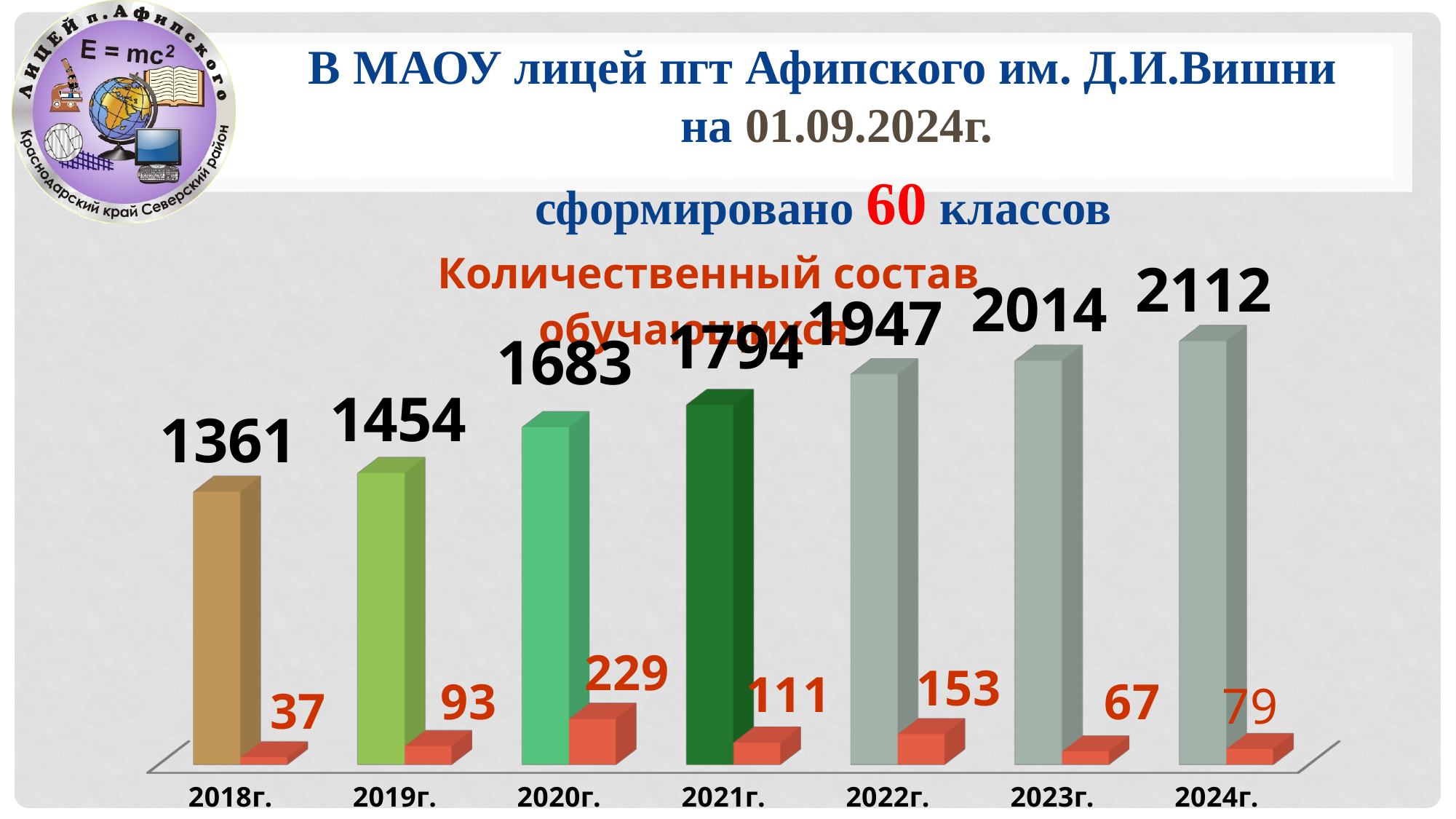
What is the difference between the tall bar values for 2024г. and 2018г.? 751 What is the value of the tall bar for 2024г.? 2112 Which year has the lowest value among the small red bars? 2018г. Do the tall bar values rise or fall from 2018г. to 2024г.? Rise What is the value of the small red bar for 2023г.? 67 Which is larger: the small red bar for 2022г. or for 2021г.? 2022г. Which year has the highest value among the small red bars? 2020г. Which year has the highest value among the tall bars? 2024г. What kind of chart is shown on the slide? Bar chart What is the value of the tall bar for 2018г.? 1361 How many years are shown on the x axis? 7 What is the value of the small red bar for 2020г.? 229